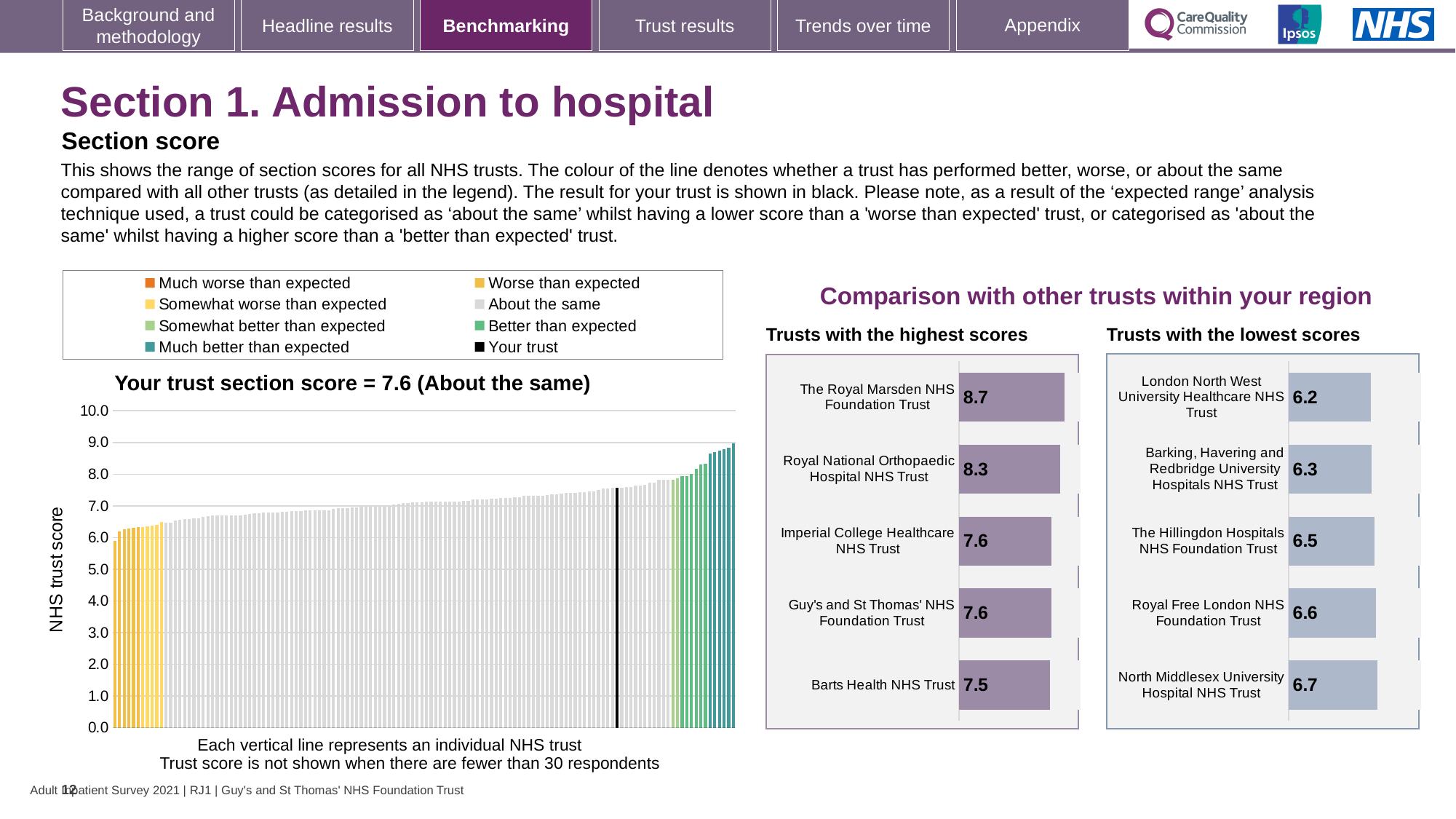
In the 'Your trust section score' chart, what is the label on the vertical axis? NHS trust score In the 'Your trust section score' chart, what is the section score for your trust? 7.6 In the 'Your trust section score' chart, what kind of chart is used to show the range of trust scores? bar chart In the 'Trusts with the lowest scores' chart, what is the difference between the scores of North Middlesex University Hospital NHS Trust and London North West University Healthcare NHS Trust? 0.5 In the 'Trusts with the lowest scores' chart, what is the score for The Hillingdon Hospitals NHS Foundation Trust? 6.5 In the 'Trusts with the lowest scores' chart, which trust has the lowest score? London North West University Healthcare NHS Trust In the 'Your trust section score' chart, how many entries does the legend list? 8 In the 'Trusts with the lowest scores' chart, which has the higher score: Royal Free London NHS Foundation Trust or Barking, Havering and Redbridge University Hospitals NHS Trust? Royal Free London NHS Foundation Trust In the 'Trusts with the highest scores' chart, which trust has the lowest score? Barts Health NHS Trust In the 'Trusts with the highest scores' chart, what is the score for The Royal Marsden NHS Foundation Trust? 8.7 In the 'Trusts with the highest scores' chart, how many trusts are shown? 5 In the 'Trusts with the highest scores' chart, what is the difference between the scores of The Royal Marsden NHS Foundation Trust and Barts Health NHS Trust? 1.2